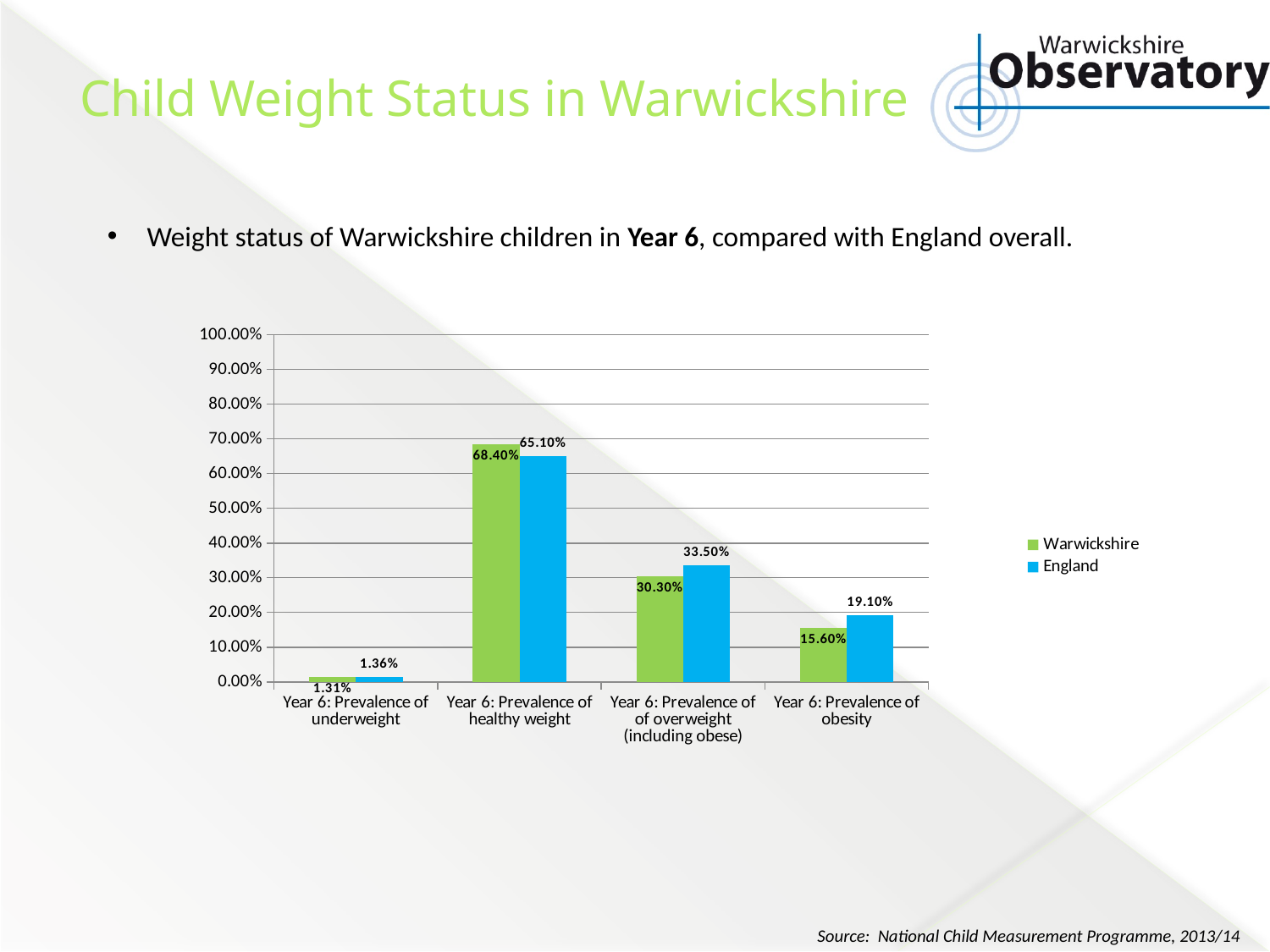
How many series does the legend list? 2 What is the England value for Year 6: Prevalence of obesity? 19.10% What kind of chart is shown on the slide? bar chart What is the difference between the England and Warwickshire values for Year 6: Prevalence of obesity? 3.50% Which category has the highest Warwickshire value? Year 6: Prevalence of healthy weight For Year 6: Prevalence of healthy weight, which is larger, the Warwickshire value or the England value? Warwickshire Which category has the lowest England value? Year 6: Prevalence of underweight What is the Warwickshire value for Year 6: Prevalence of healthy weight? 68.40% What is the England value for Year 6: Prevalence of overweight (including obese)? 33.50% What is the Warwickshire value for Year 6: Prevalence of underweight? 1.31% How many categories are shown on the x axis? 4 Is the Warwickshire value for Year 6: Prevalence of overweight (including obese) greater or less than 40.00%? less